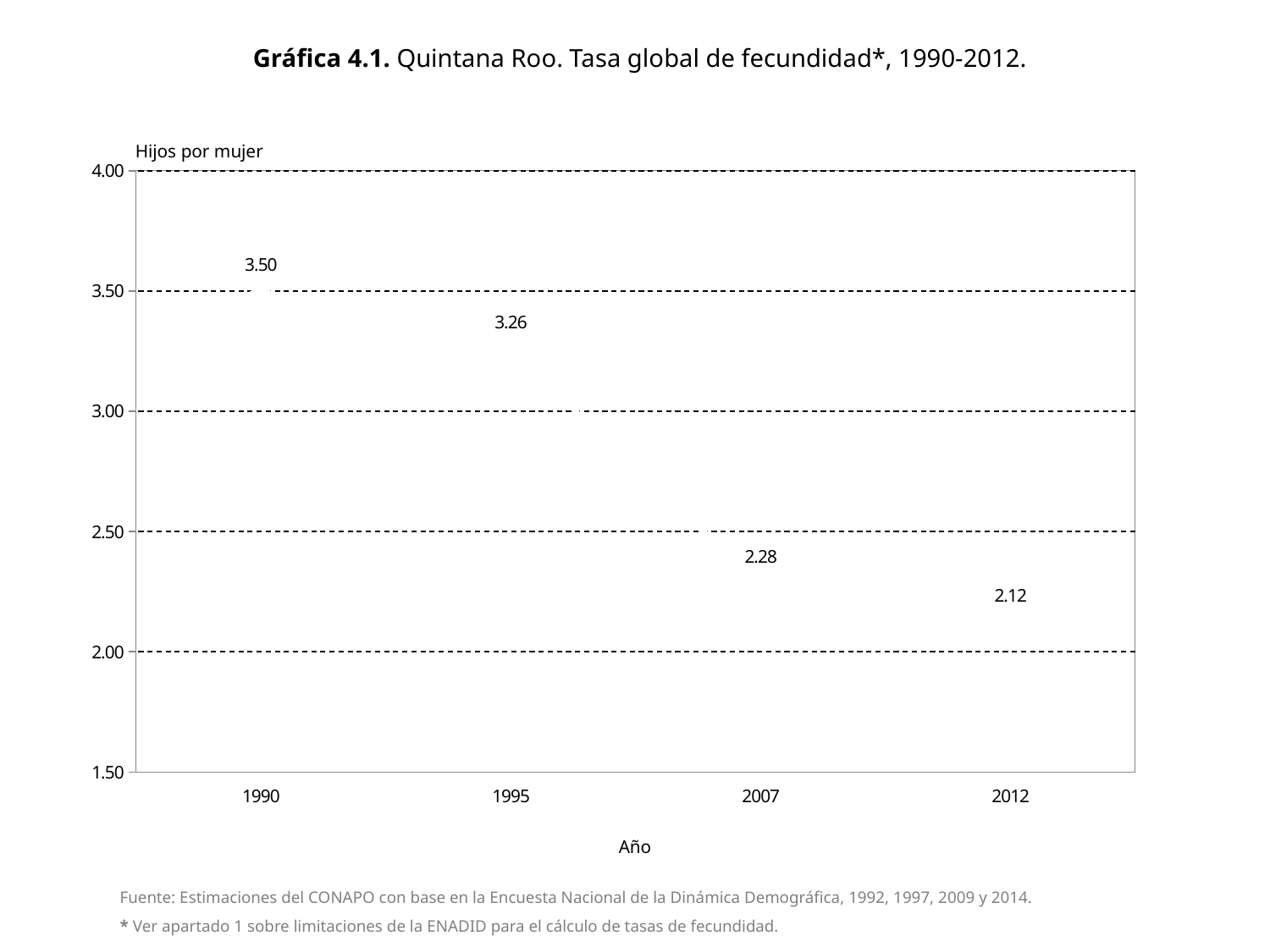
Which year has the highest total fertility rate? 1990 What is the value shown for 1995? 3.26 What is the label of the vertical axis? Hijos por mujer Which year has the lowest total fertility rate? 2012 What is the value shown for 2007? 2.28 How many years (data points) are plotted on the chart? 4 What is the difference between the values for 1990 and 2012? 1.38 What is the difference between the values for 1995 and 2007? 0.98 What is the value shown for 2012? 2.12 Which is larger, the value for 1995 or the value for 2007? 1995 Do the values rise or fall from 1990 to 2012? fall What is the total fertility rate (hijos por mujer) shown for 1990? 3.50